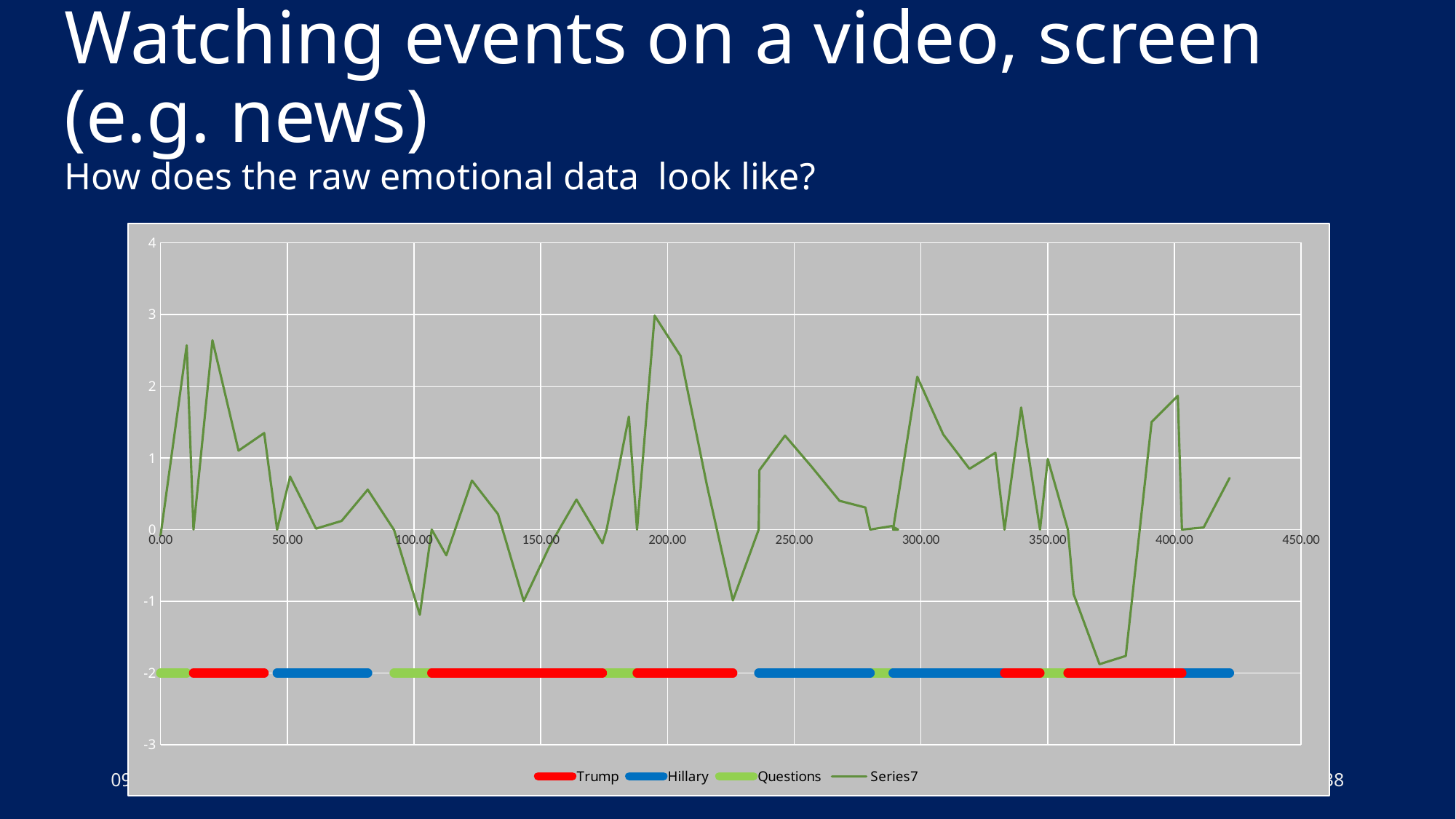
Is the highest value of Series7 greater or less than 2? greater Is the value of Series7 at x = 50.00 greater or less than 1? less What kind of chart is shown on the slide? line chart What is the highest value shown on the y axis? 4 Does Series7 rise or fall between x = 350.00 and x = 375.00? fall Which series is drawn in red in the legend? Trump Is the value of Series7 at x = 200.00 greater or less than 2? greater At which y-axis value are the Trump, Hillary and Questions segments drawn? -2 How many series does the legend list? 4